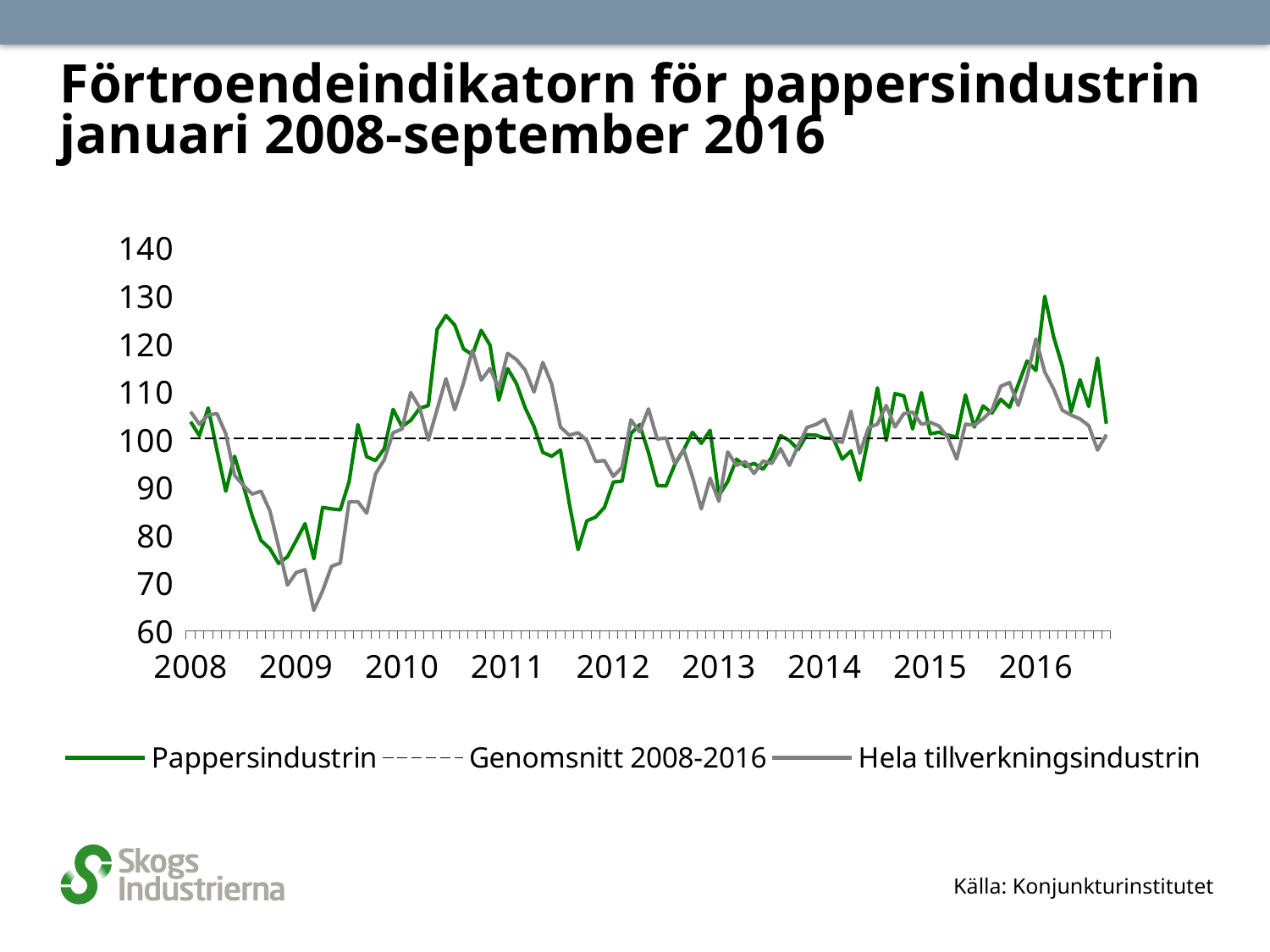
Is the highest value of Pappersindustrin in 2016 greater or less than 120? greater What kind of chart is shown on the slide? line chart What is the title of the chart? Förtroendeindikatorn för pappersindustrin januari 2008-september 2016 Which series is drawn as a dashed line? Genomsnitt 2008-2016 Is the Genomsnitt 2008-2016 line greater or less than 110? less Which series reaches the lowest value on the chart? Hela tillverkningsindustrin How many series does the legend list? 3 Is the lowest value of Hela tillverkningsindustrin in 2009 greater or less than 70? less At the peak in 2016, which series is higher, Pappersindustrin or Hela tillverkningsindustrin? Pappersindustrin Which series reaches the highest value on the chart? Pappersindustrin Do the values of Pappersindustrin rise or fall from 2008 to early 2009? fall